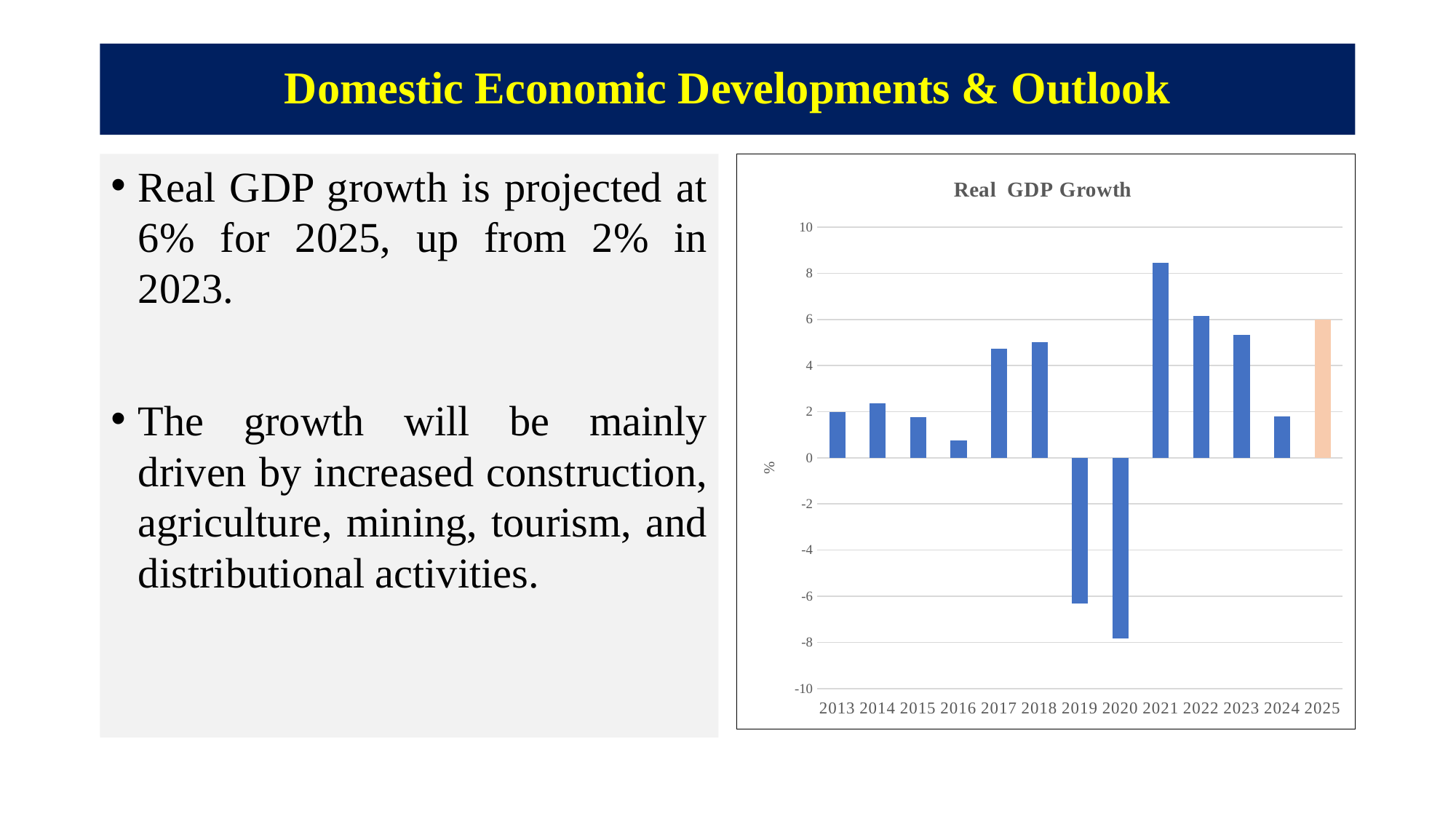
How many years are plotted on the x axis of the chart? 13 Do the values rise or fall from 2021 to 2024? fall Which year has the lowest real GDP growth in the chart? 2020 What kind of chart is shown on the slide? bar chart What is the real GDP growth value shown for 2025? 6 Which year has the larger value, 2022 or 2023? 2022 Is the value for 2016 greater or less than 2? less Which year has the highest real GDP growth in the chart? 2021 Is the value for 2019 greater or less than -6? less Is the value for 2021 greater or less than 8? greater What is the title of the chart? Real GDP Growth Which year's bar is shown in a different colour from the rest? 2025